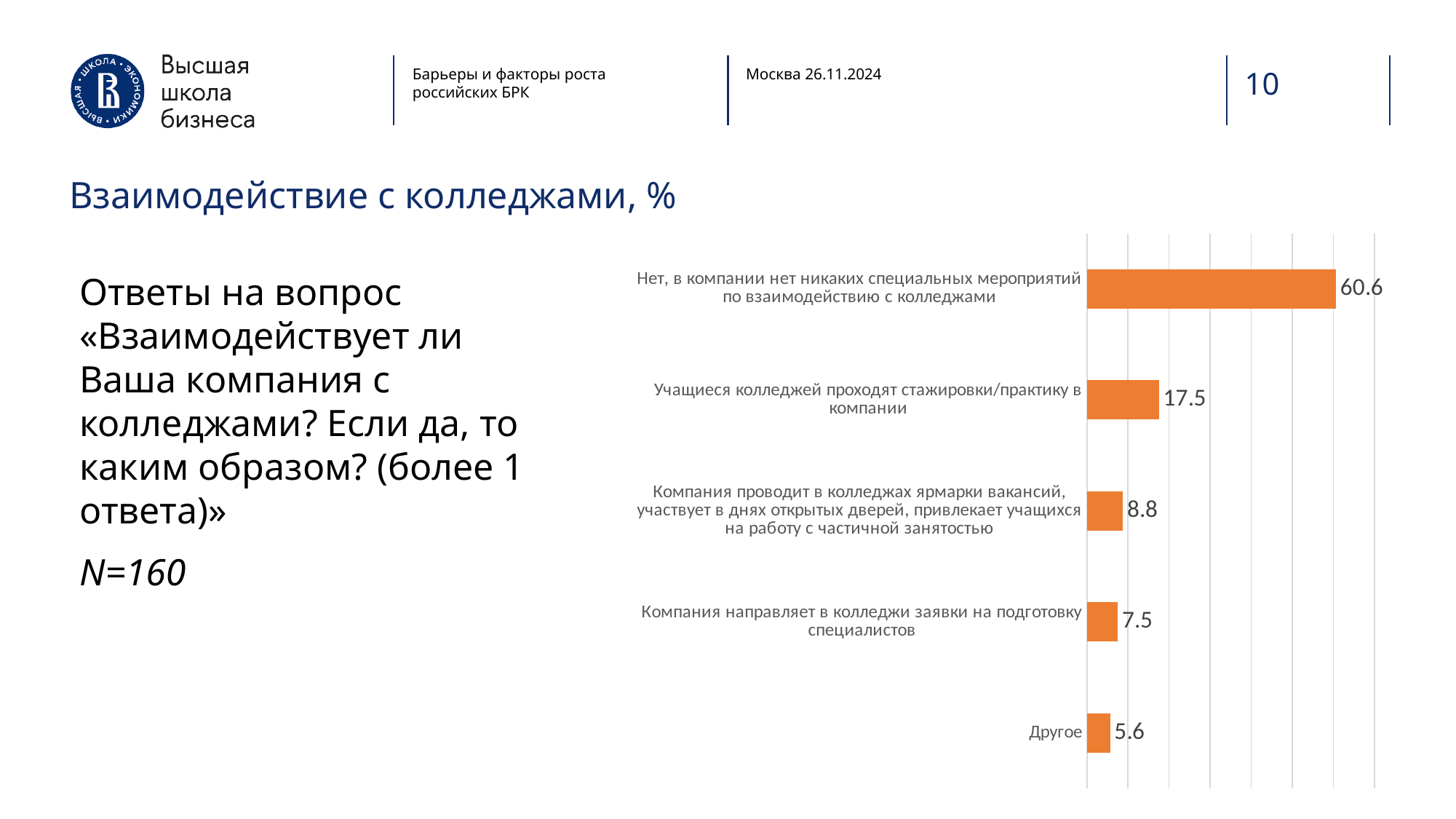
What value is shown for "Учащиеся колледжей проходят стажировки/практику в компании"? 17.5 What value is shown for the bar about the company holding job fairs in colleges and participating in open days? 8.8 What type of chart is shown on the slide? Bar chart How many categories are shown in the chart? 5 Which category has the highest value? Нет, в компании нет никаких специальных мероприятий по взаимодействию с колледжами What is the difference between the values for "Компания проводит в колледжах ярмарки вакансий..." and "Компания направляет в колледжи заявки на подготовку специалистов"? 1.3 What is the title of the chart on the slide? Взаимодействие с колледжами, % What is the difference between the value for "Нет, в компании нет никаких специальных мероприятий по взаимодействию с колледжами" and the value for "Учащиеся колледжей проходят стажировки/практику в компании"? 43.1 Which is larger: the value for "Компания направляет в колледжи заявки на подготовку специалистов" or the value for "Другое"? Компания направляет в колледжи заявки на подготовку специалистов What value is shown for "Другое"? 5.6 What value is shown for "Компания направляет в колледжи заявки на подготовку специалистов"? 7.5 Which category has the lowest value? Другое